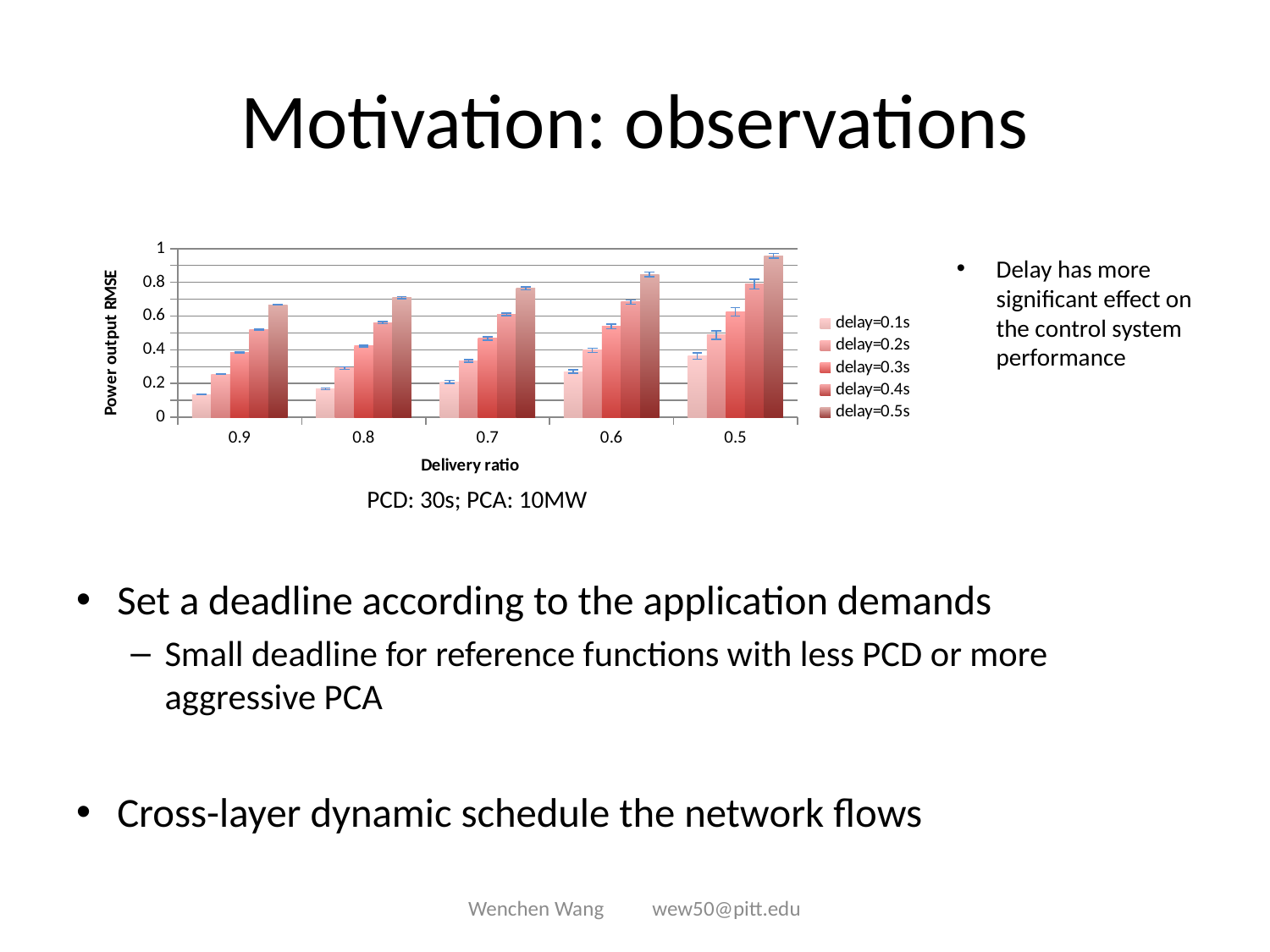
Is the value for delay=0.5s at delivery ratio 0.9 greater or less than 0.6? greater Is the value for delay=0.1s at delivery ratio 0.9 greater or less than 0.2? less Is the value for delay=0.5s at delivery ratio 0.5 greater or less than 0.8? greater Which delivery ratio has the lowest delay=0.1s bar? 0.9 Which delivery ratio has the highest delay=0.5s bar? 0.5 Which is larger: delay=0.5s at delivery ratio 0.9 or delay=0.1s at delivery ratio 0.5? delay=0.5s at delivery ratio 0.9 How many series does the legend list? 5 As the delivery ratio decreases from 0.9 to 0.5 along the x axis, do the delay=0.3s values rise or fall? rise What is the label of the y axis? Power output RMSE What is the label of the x axis? Delivery ratio How many delivery ratio categories are shown on the x axis? 5 What kind of chart is shown on the slide? bar chart